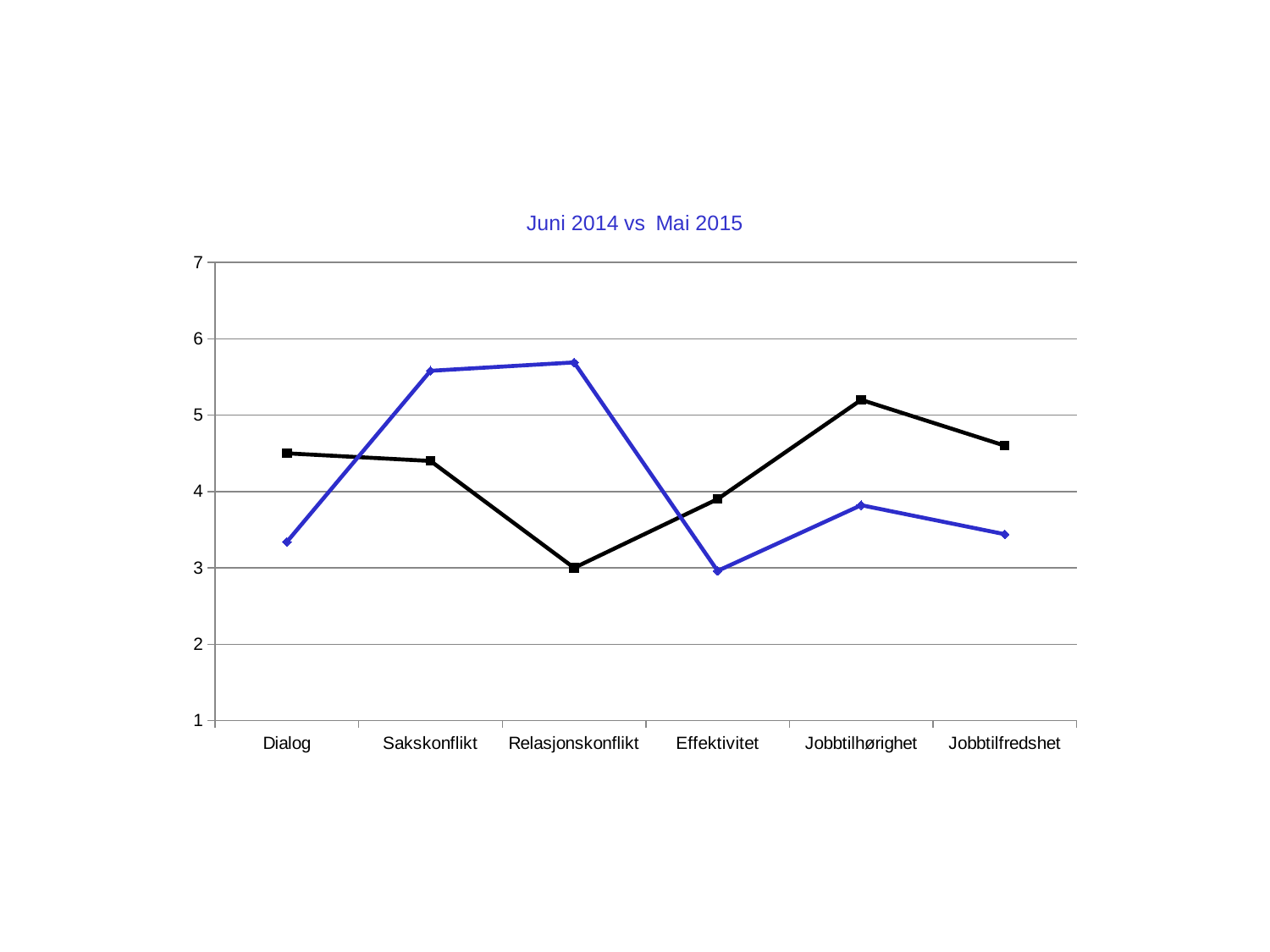
For which category does the black line reach its lowest value? Relasjonskonflikt How many categories are shown on the x axis? 6 Does the blue line rise or fall from Jobbtilhørighet to Jobbtilfredshet? fall Is the value of the blue line for Dialog greater or less than 4? less At Sakskonflikt, which line has the higher value, the blue line or the black line? the blue line Is the value of the black line for Jobbtilhørighet greater or less than 5? greater What kind of chart is shown on the slide? line chart What is the title of the chart? Juni 2014 vs Mai 2015 Is the value of the blue line for Sakskonflikt greater or less than 5? greater For which category does the blue line reach its lowest value? Effektivitet How many lines are plotted on the chart? 2 For which category does the black line reach its highest value? Jobbtilhørighet